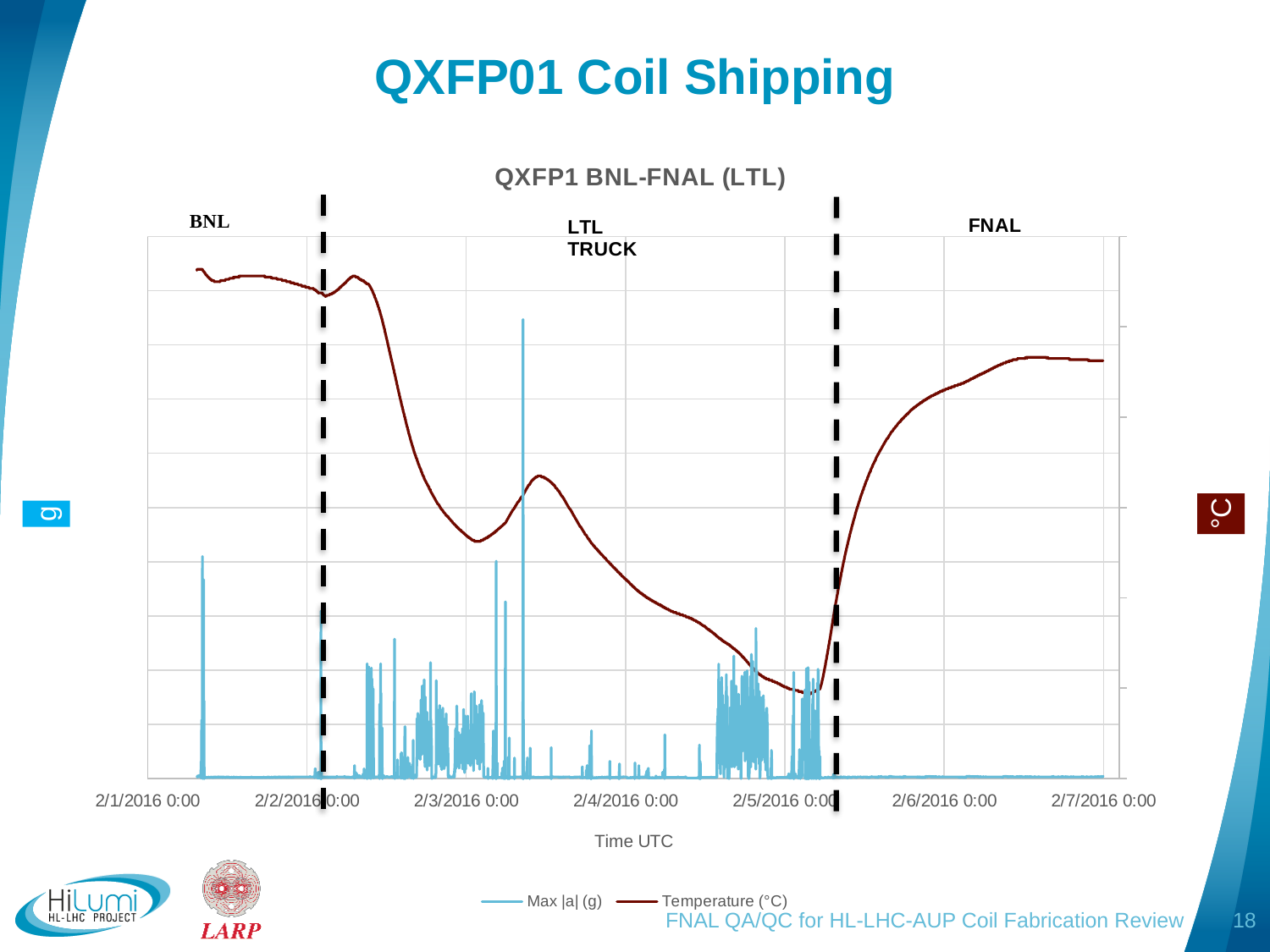
What is the title of the chart? QXFP1 BNL-FNAL (LTL) Does the Temperature (°C) series rise or fall between 2/2/2016 0:00 and 2/5/2016 0:00? Fall Which of the three labelled segments of the chart (BNL, LTL TRUCK, FNAL) contains the tallest Max |a| (g) spike? LTL TRUCK What is the label of the x axis? Time UTC How many date labels are shown along the x axis? 7 What is the first date label on the x axis? 2/1/2016 0:00 What kind of chart is shown on the slide? Line chart How many series does the chart legend list? 2 What is the last date label on the x axis? 2/7/2016 0:00 Near which x-axis date label does the Temperature (°C) series reach its lowest point? 2/5/2016 0:00 What are the two series named in the chart legend? Max |a| (g) and Temperature (°C) Does the Temperature (°C) series rise or fall between 2/5/2016 0:00 and 2/6/2016 0:00? Rise